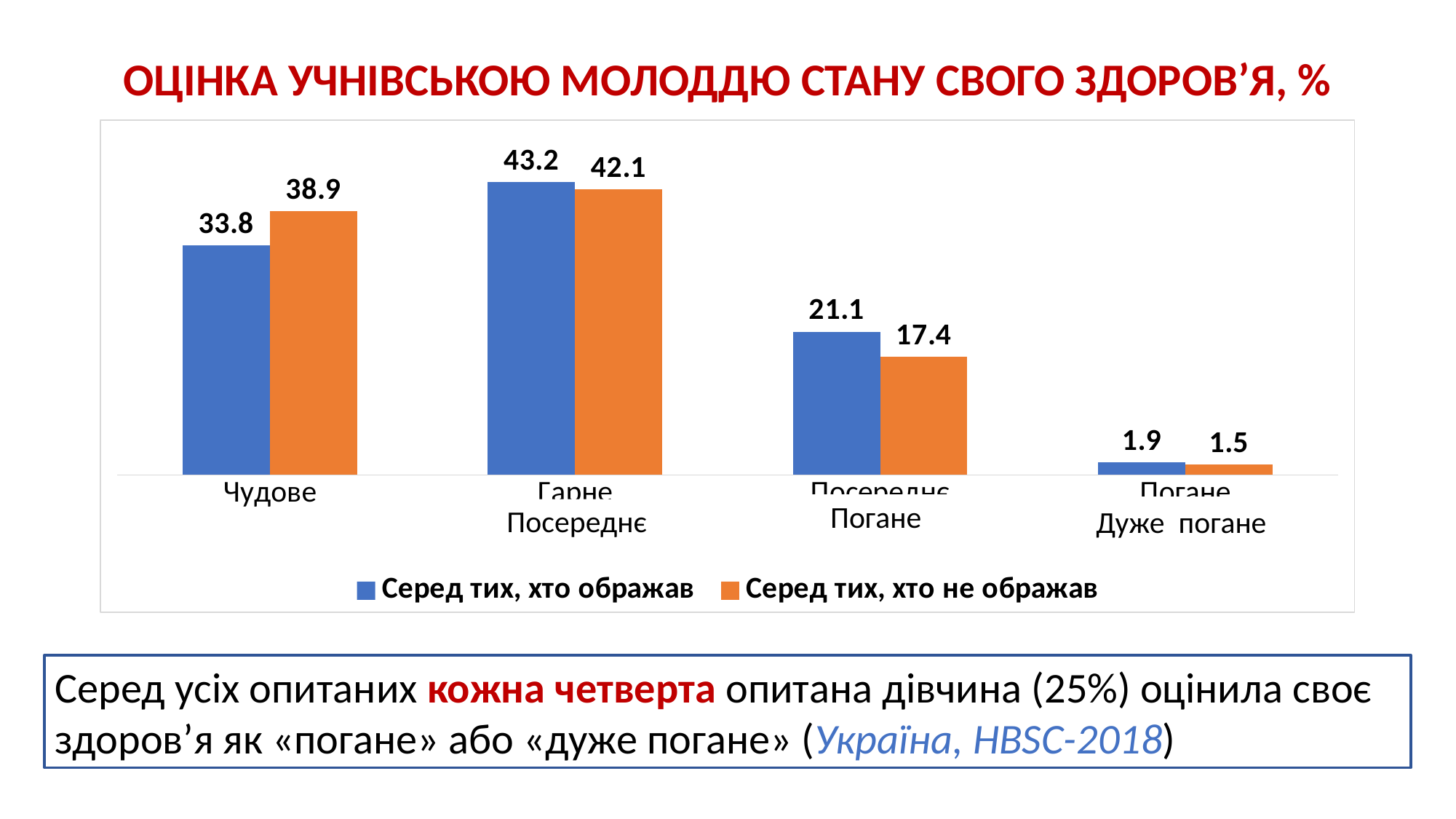
What is the value for "Чудове" in the series "Серед тих, хто ображав"? 33.8 For "Чудове", what is the difference between the "Серед тих, хто не ображав" value and the "Серед тих, хто ображав" value? 5.1 For the third category from the left, what is the difference between the blue bar and the orange bar? 3.7 How many categories are shown on the x axis? 4 What type of chart is shown on the slide? Bar chart Which category has the lowest value in the series "Серед тих, хто не ображав"? The rightmost category How many series does the legend list? 2 Which category has the highest value in the series "Серед тих, хто ображав"? The second category from the left What is the value of the orange bar for the rightmost category? 1.5 For "Чудове", which series has the larger value? Серед тих, хто не ображав What is the value of the blue bar for the second category from the left? 43.2 What is the value for "Чудове" in the series "Серед тих, хто не ображав"? 38.9